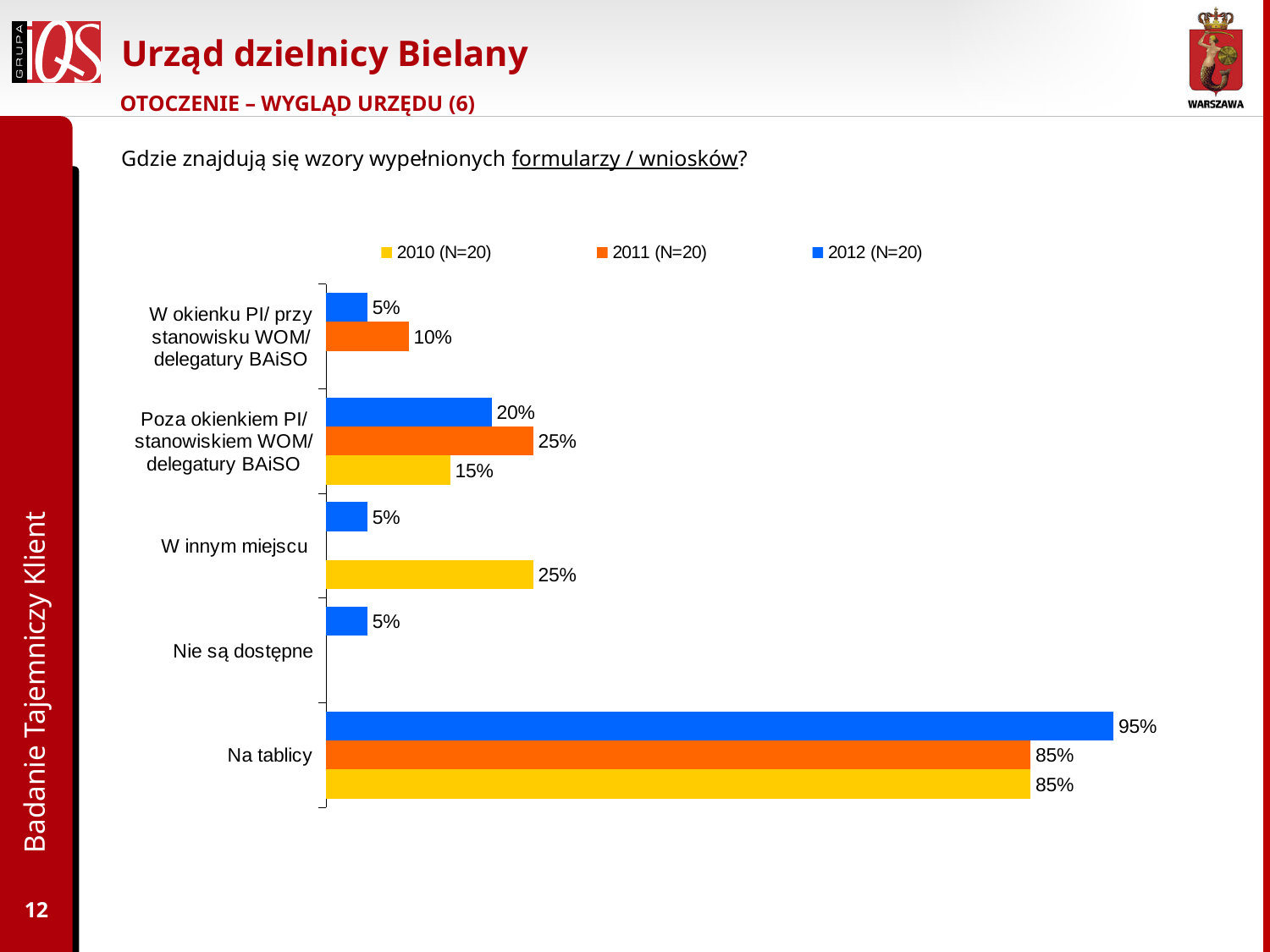
What is the value for 'Na tablicy' in the 2012 (N=20) series? 95% What is the value for 'Nie są dostępne' in the 2012 (N=20) series? 5% How many series does the legend list? 3 What is the difference between the 2012 (N=20) and 2011 (N=20) values for 'Na tablicy'? 10% What is the value for 'W okienku PI/ przy stanowisku WOM/ delegatury BAiSO' in the 2011 (N=20) series? 10% Which category has the highest value in the 2012 (N=20) series? Na tablicy What kind of chart is shown on the slide? bar chart Which is larger for 'Poza okienkiem PI/ stanowiskiem WOM/ delegatury BAiSO': the 2011 (N=20) value or the 2012 (N=20) value? 2011 (N=20) What is the value for 'W innym miejscu' in the 2010 (N=20) series? 25% How many categories are shown on the chart? 5 What is the value for 'Poza okienkiem PI/ stanowiskiem WOM/ delegatury BAiSO' in the 2010 (N=20) series? 15% Which colour represents the 2011 (N=20) series in the legend? orange